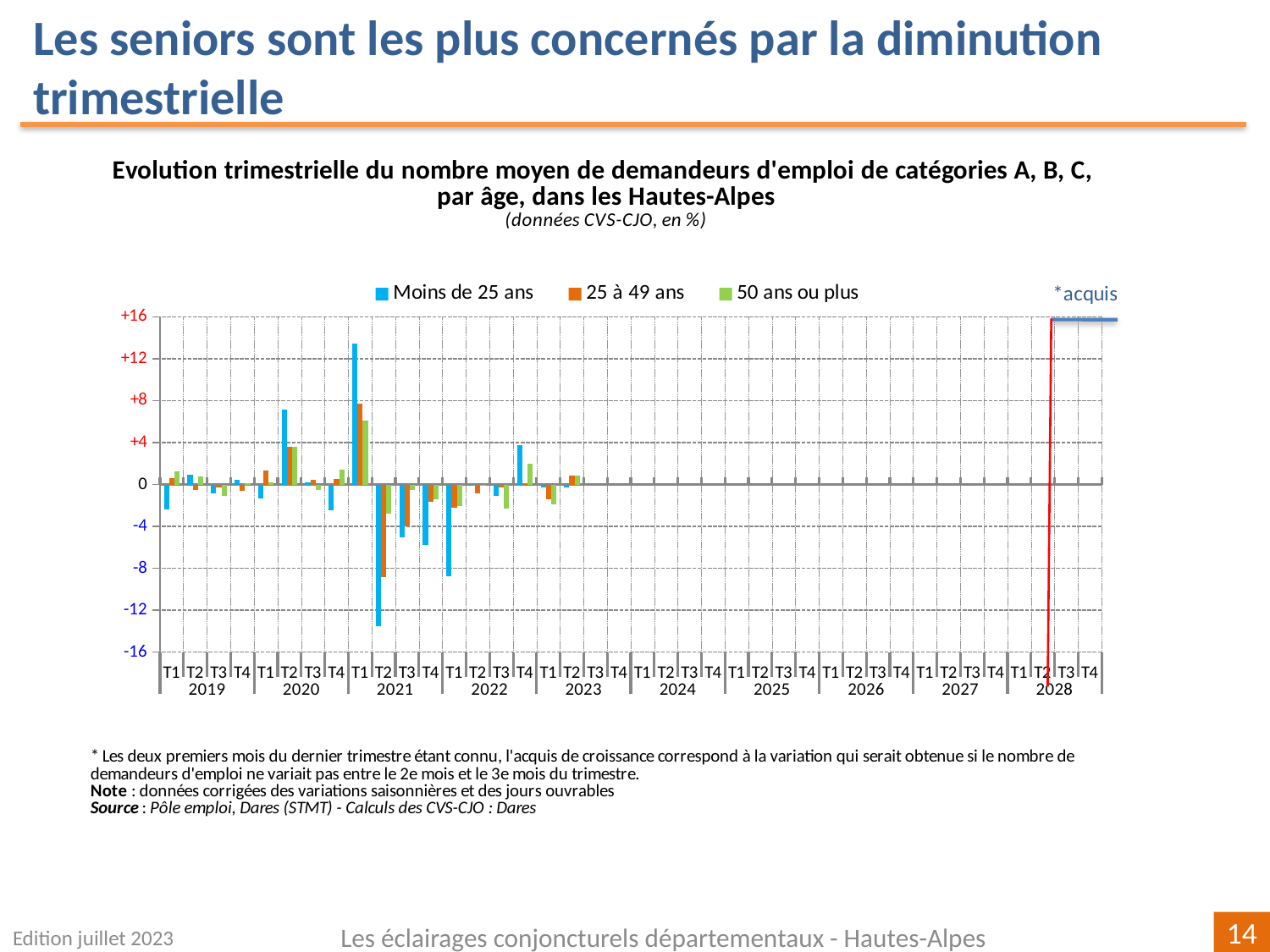
Is the value for 25 à 49 ans in T2 2021 greater or less than -8? less Is the value for 50 ans ou plus in T1 2021 greater or less than +4? greater Is the value for Moins de 25 ans in T2 2021 greater or less than -12? less In which quarter does the Moins de 25 ans series reach its lowest value? T2 2021 What kind of chart is shown on the slide? bar chart Which series is shown in green in the legend? 50 ans ou plus In T1 2021, which series has the larger value: Moins de 25 ans or 25 à 49 ans? Moins de 25 ans How many series does the legend list? 3 Which series is shown in orange in the legend? 25 à 49 ans In which quarter does the Moins de 25 ans series reach its highest value? T1 2021